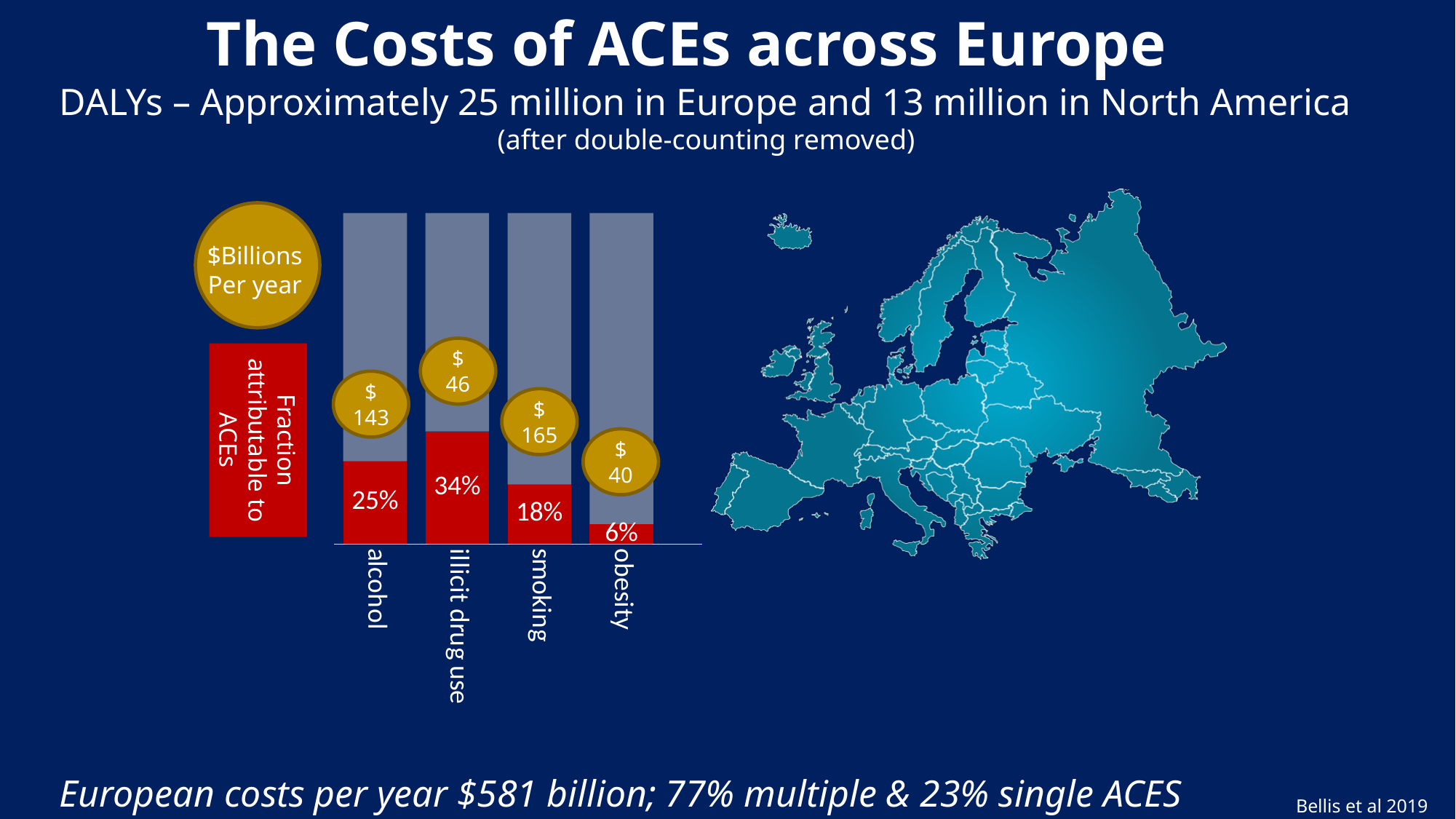
What is the annual cost in $billions shown for smoking? $165 How many categories are shown in the bar chart? 4 Which category has the highest fraction attributable to ACEs? illicit drug use What type of chart is used to show the fraction attributable to ACEs? bar chart What is the difference in percentage points between the ACE-attributable fraction for alcohol and for smoking? 7 What is the annual cost in $billions shown for obesity? $40 What fraction of alcohol costs is attributable to ACEs? 25% What fraction of illicit drug use costs is attributable to ACEs? 34% Which category has the highest annual cost in $billions? smoking Which category has the lowest fraction attributable to ACEs? obesity What is the difference in $billions per year between the cost for alcohol and the cost for illicit drug use? $97 Which has a larger annual cost in $billions, alcohol or obesity? alcohol